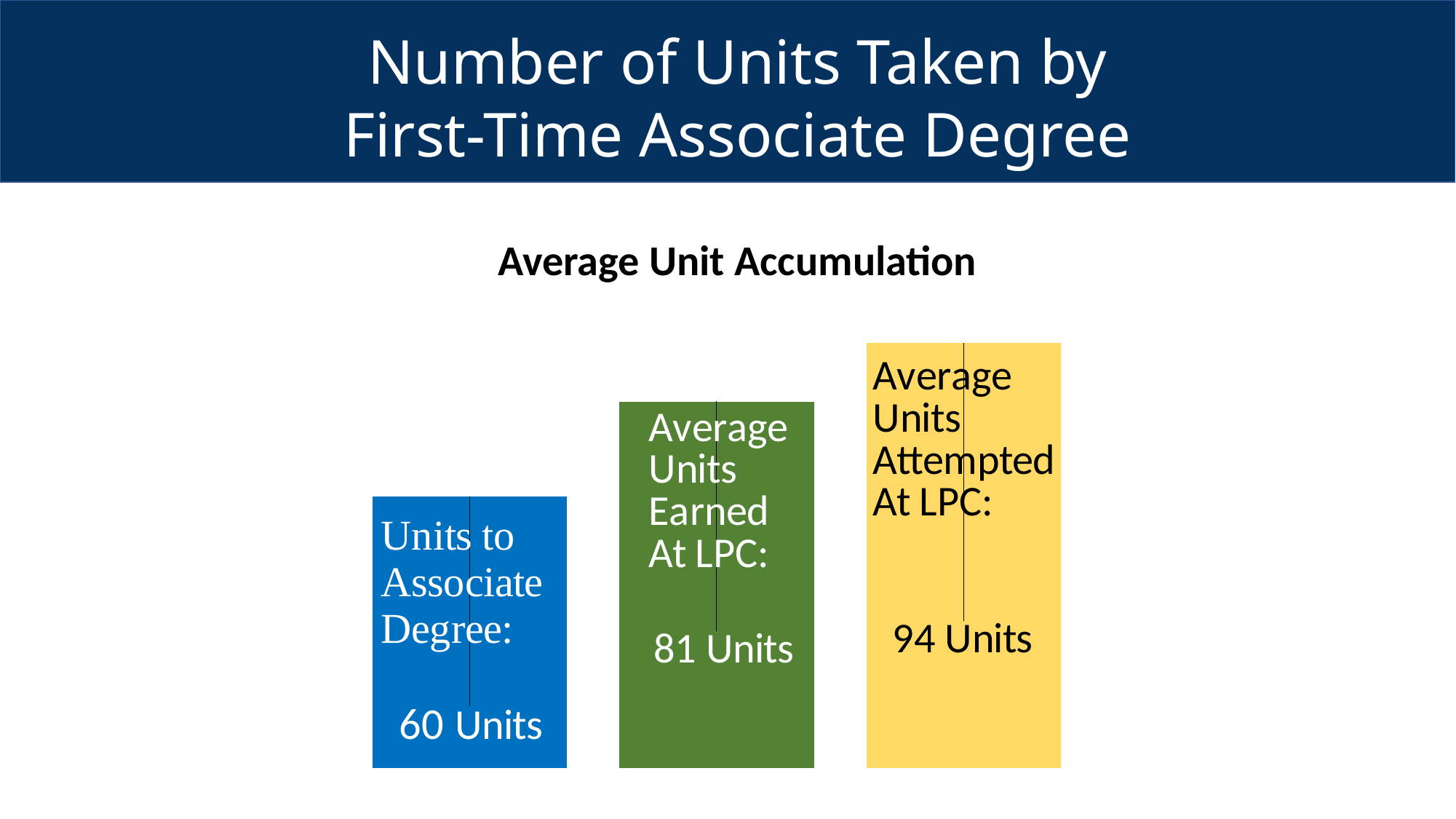
What kind of chart is shown on the slide? Bar chart What is the value for Units to Associate Degree? 60 Units Which is larger: Average Units Earned At LPC or Average Units Attempted At LPC? Average Units Attempted At LPC What is the difference between Average Units Earned At LPC and Units to Associate Degree? 21 Units What is the value for Average Units Attempted At LPC? 94 Units What is the difference between Average Units Attempted At LPC and Units to Associate Degree? 34 Units What is the title of the chart? Average Unit Accumulation What is the value for Average Units Earned At LPC? 81 Units Do the values rise or fall from left to right across the bars? Rise Which category has the highest value? Average Units Attempted At LPC How many bars are shown in the chart? 3 Which category has the lowest value? Units to Associate Degree